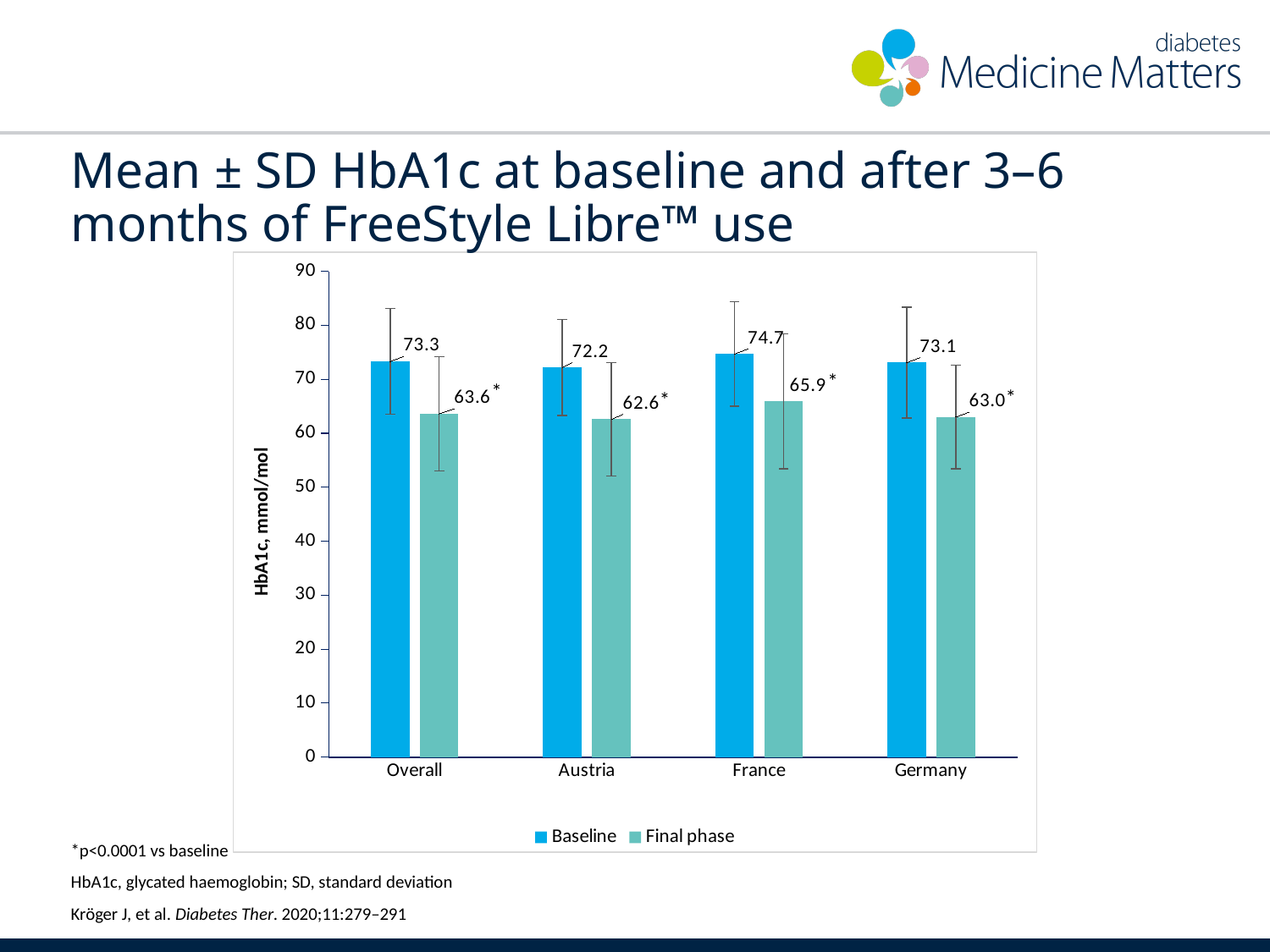
What is the difference between the Baseline and Final phase values for Germany? 10.1 What is the Baseline HbA1c value for France? 74.7 What is the Final phase HbA1c value for Overall? 63.6 Which is larger, the Final phase value for France or the Final phase value for Germany? France What is the Final phase HbA1c value for Austria? 62.6 How many series does the legend list? 2 Which category has the highest Baseline value? France Is the Baseline value for Austria greater or less than 70? greater What is the difference between the Baseline and Final phase values for Overall? 9.7 How many categories are shown on the x axis? 4 What kind of chart is shown on the slide? Bar chart Which category has the lowest Final phase value? Austria